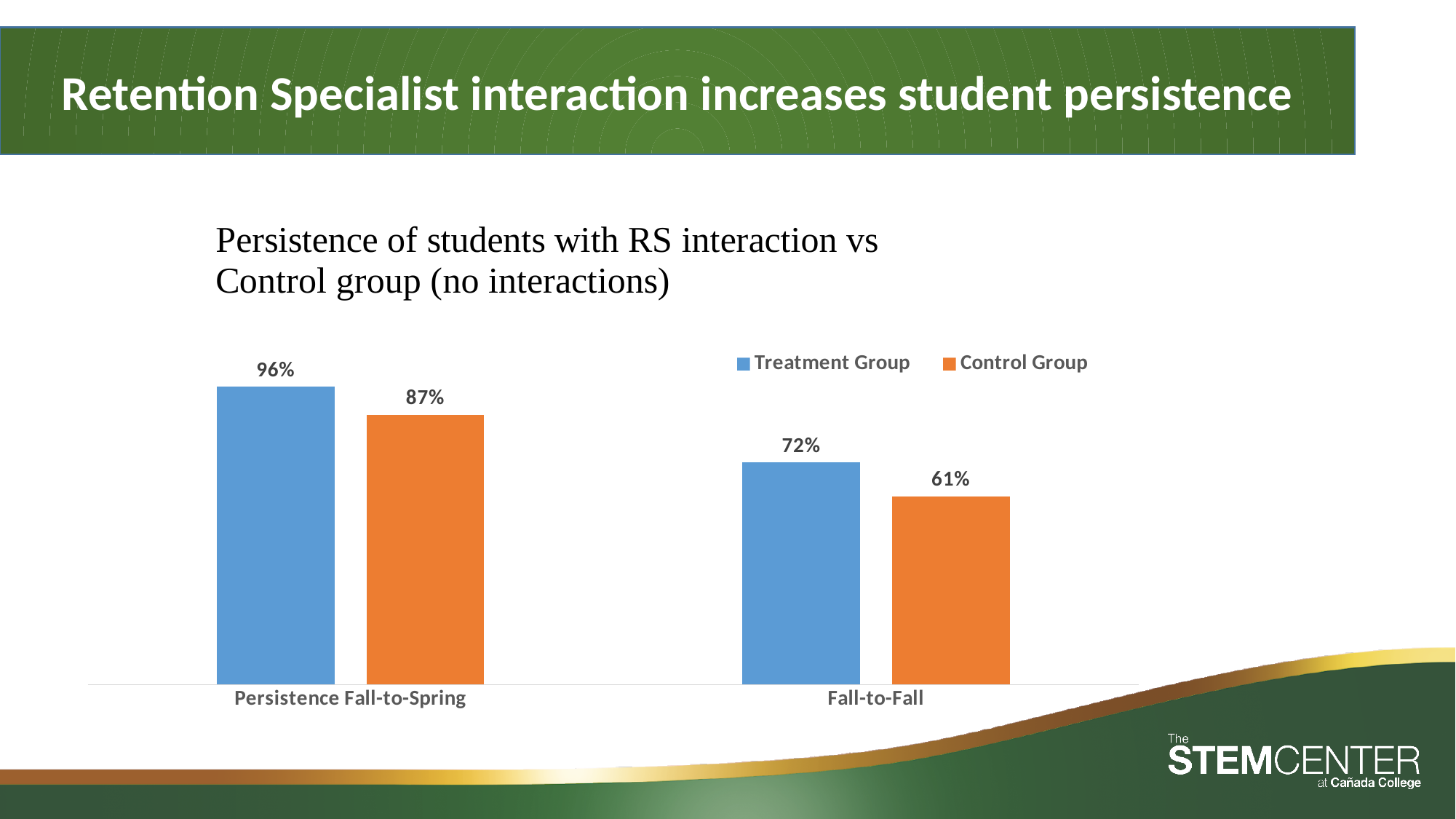
Which bar has the highest value on the chart? Treatment Group, Persistence Fall-to-Spring What kind of chart is shown on the slide? Bar chart How many series does the legend list? 2 What is the difference between the Treatment Group and Control Group values for Fall-to-Fall? 11% Which bar has the lowest value on the chart? Control Group, Fall-to-Fall How many categories are shown on the x axis? 2 What is the difference between the Treatment Group and Control Group values for Persistence Fall-to-Spring? 9% What is the Control Group value for Persistence Fall-to-Spring? 87% What is the Treatment Group value for Persistence Fall-to-Spring? 96% What is the Treatment Group value for Fall-to-Fall? 72% What is the Control Group value for Fall-to-Fall? 61% Which is larger for Fall-to-Fall, the Treatment Group or the Control Group? Treatment Group